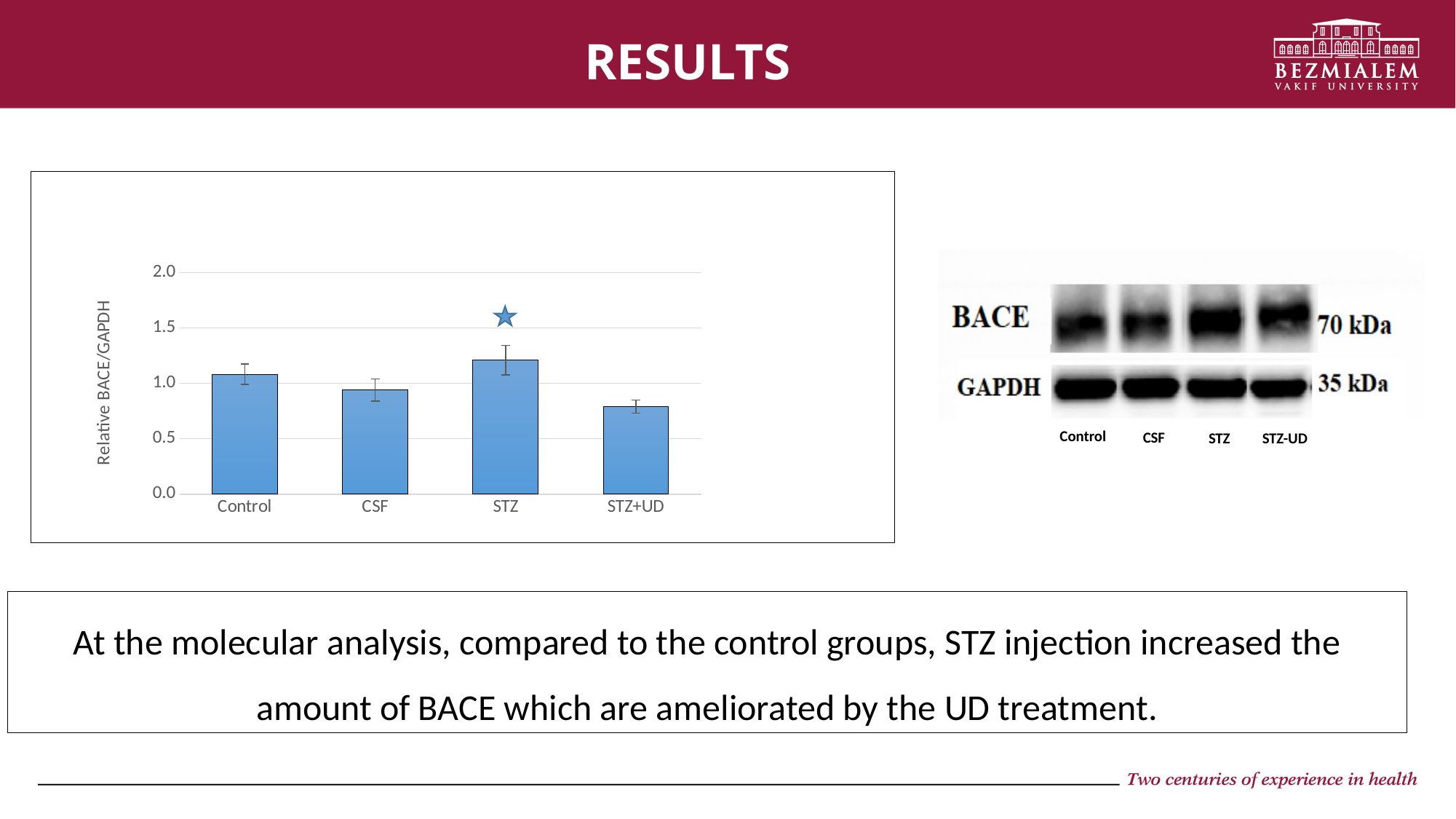
Which category has the lowest Relative BACE/GAPDH value? STZ+UD What is the label of the y axis of the bar chart? Relative BACE/GAPDH Is the value for STZ greater or less than 1.5? less Is the value for Control greater or less than 1.0? greater How many categories are shown on the x axis of the bar chart? 4 Above which bar is a star marker placed? STZ Which has the larger value, Control or CSF? Control Which category has the highest Relative BACE/GAPDH value? STZ Is the value for CSF greater or less than 0.5? greater What kind of chart is shown on the slide? bar chart Which has the larger value, STZ or STZ+UD? STZ